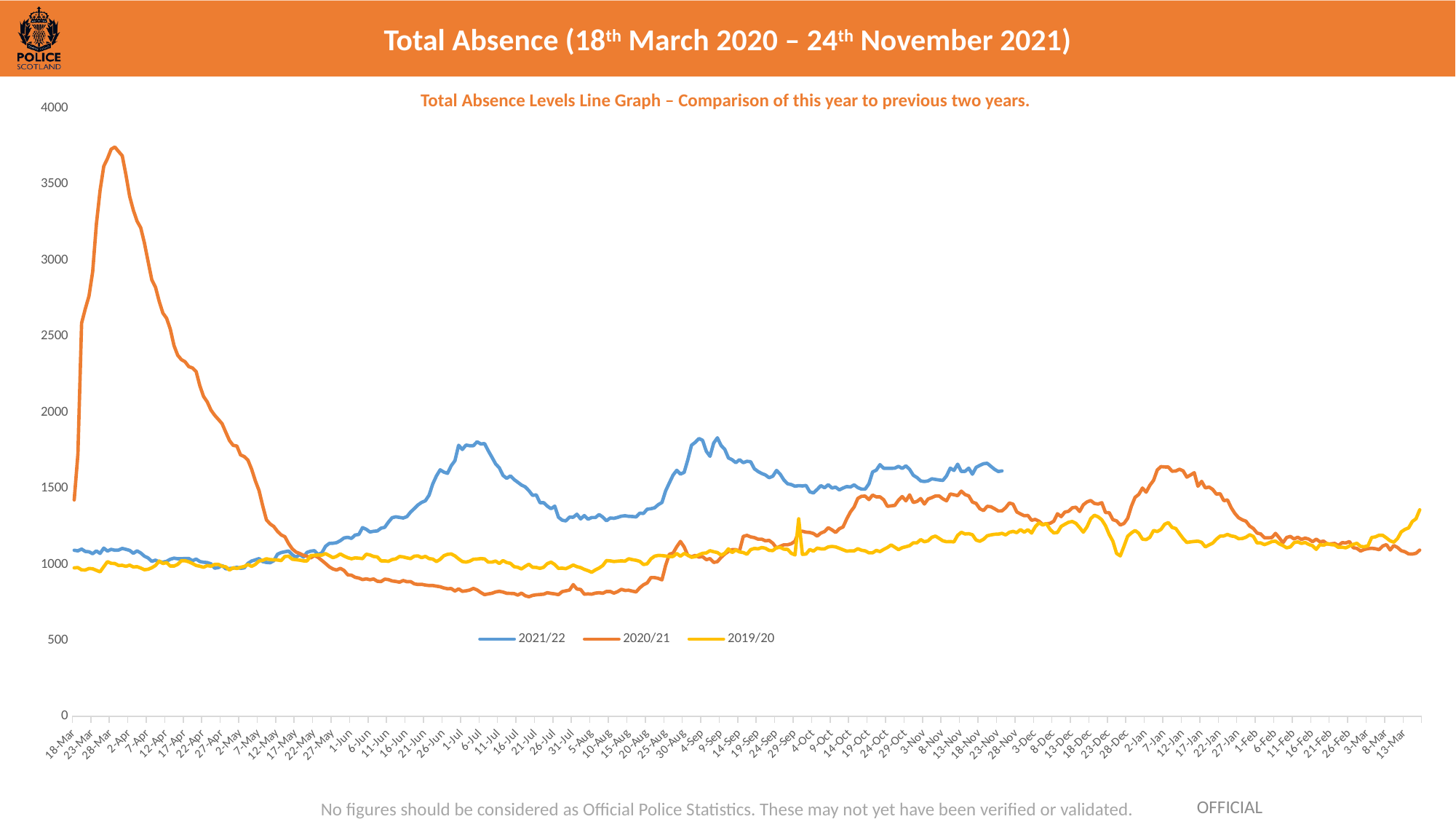
Around 6-Jul, which series has the larger value, 2021/22 or 2019/20? 2021/22 Around 2-Apr, which series has the larger value, 2020/21 or 2021/22? 2020/21 Is the peak value of the 2020/21 series around 2-Apr greater or less than 3500? greater Which series reaches the highest value anywhere on the chart? 2020/21 What is the title printed above the chart? Total Absence Levels Line Graph – Comparison of this year to previous two years. Is the value of the 2021/22 series around 6-Jul greater or less than 1500? greater Does the 2020/21 series rise or fall between 2-Apr and 12-May? fall Is the value of the 2020/21 series around 16-Jul greater or less than 1000? less Which series is drawn in blue according to the legend? 2021/22 What kind of chart is shown on the slide? Line chart How many series does the legend list? 3